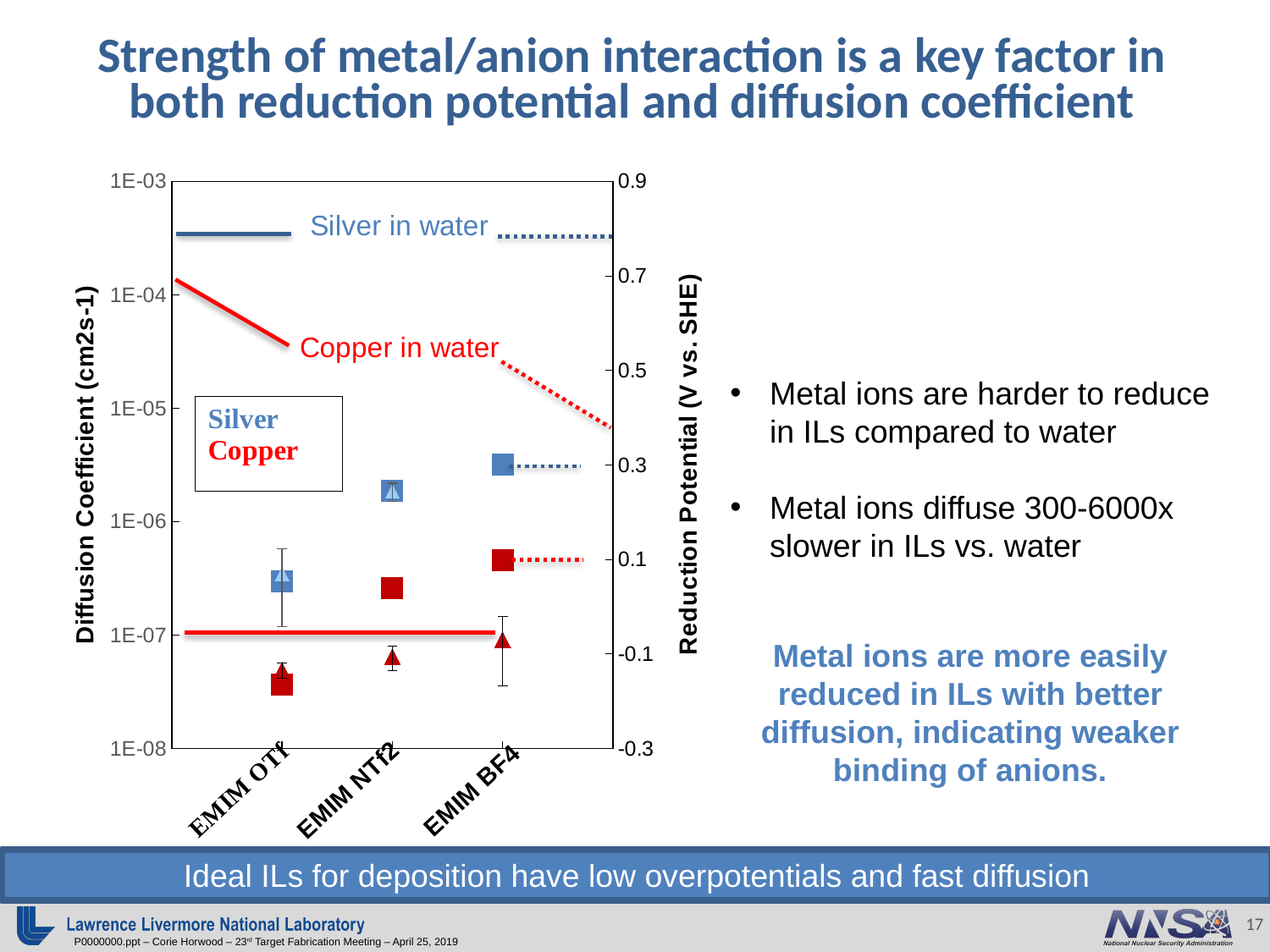
Among the blue square markers, which category has the lowest position on the chart? EMIM OTf What is the label of the right y axis of the chart? Reduction Potential (V vs. SHE) Reading the blue triangle marker for EMIM OTf against the left axis, is its value greater or less than 1E-07? greater Which is positioned higher on the chart: the blue square marker for EMIM BF4 or the blue square marker for EMIM OTf? EMIM BF4 How many series does the legend box in the chart list? 2 Reading the blue triangle marker for EMIM NTf2 against the left axis, is its value greater or less than 1E-06? greater Reading the red triangle marker for EMIM OTf against the left axis, is its value greater or less than 1E-07? less Do the blue square markers rise or fall moving from EMIM OTf to EMIM BF4 along the x axis? rise What is the label of the left y axis of the chart? Diffusion Coefficient (cm2s-1) What kind of chart is shown on the slide? scatter chart How many ionic liquid categories are labelled on the x axis of the chart? 3